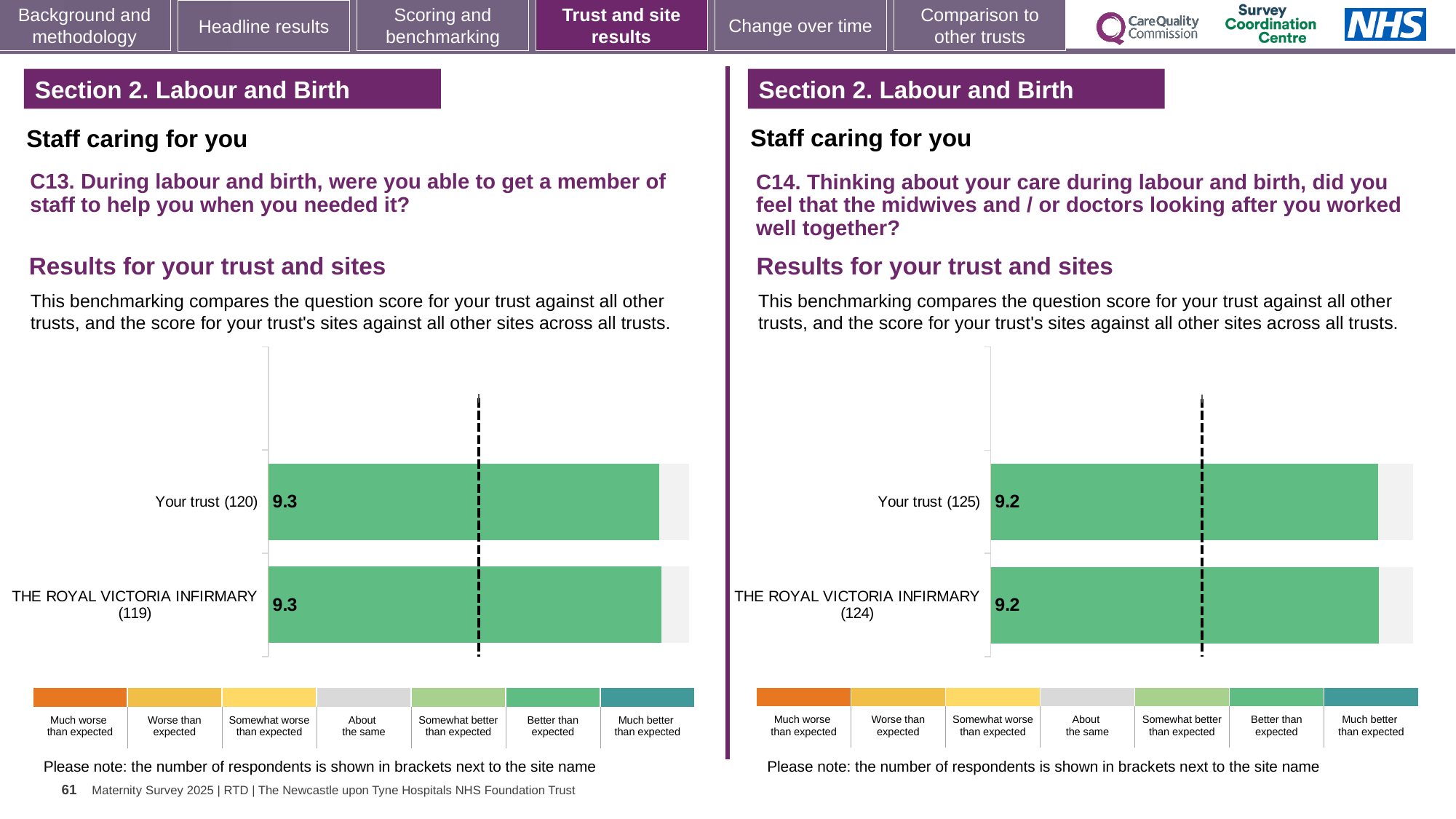
On the right chart (C14), what is the score for THE ROYAL VICTORIA INFIRMARY? 9.2 On the right chart (C14), what is the difference between the score for Your trust and the score for THE ROYAL VICTORIA INFIRMARY? 0 How many bars are plotted on the left chart (C13)? 2 Is the score for Your trust on the left chart (C13) larger or smaller than the score for Your trust on the right chart (C14)? Larger On the left chart (C13), what is the difference between the score for Your trust and the score for THE ROYAL VICTORIA INFIRMARY? 0 On the left chart (C13), how many respondents are shown in brackets for Your trust? 120 On the left chart (C13), what is the score for THE ROYAL VICTORIA INFIRMARY? 9.3 On the right chart (C14), how many respondents are shown in brackets for THE ROYAL VICTORIA INFIRMARY? 124 On the left chart (C13), what is the score for Your trust? 9.3 On the right chart (C14), what is the score for Your trust? 9.2 How many bars are plotted on the right chart (C14)? 2 What kind of chart is used on the left (C13)? Bar chart